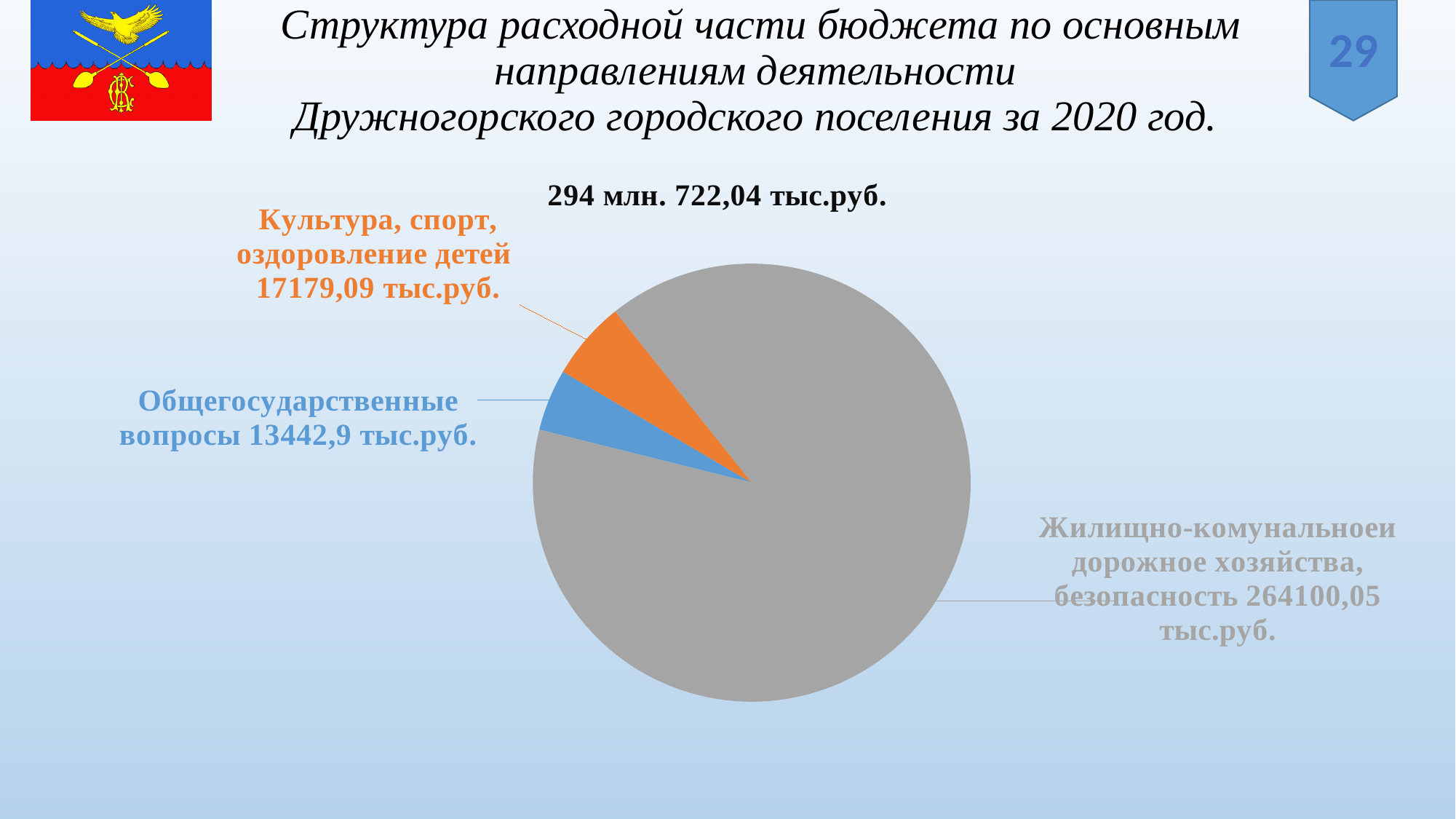
What is the value for Культура, спорт, оздоровление детей? 17179,09 тыс.руб. Which is larger: Культура, спорт, оздоровление детей or Общегосударственные вопросы? Культура, спорт, оздоровление детей What kind of chart is shown on the slide? Pie chart How many slices does the pie chart have? 3 What is the value for Общегосударственные вопросы? 13442,9 тыс.руб. What colour is the slice for Общегосударственные вопросы? Blue Which category has the smallest slice of the pie? Общегосударственные вопросы What is the difference between Жилищно-коммунальное и дорожное хозяйства, безопасность and Культура, спорт, оздоровление детей? 246920,96 тыс.руб. Which category has the largest slice of the pie? Жилищно-коммунальное и дорожное хозяйства, безопасность What is the difference between Культура, спорт, оздоровление детей and Общегосударственные вопросы? 3736,19 тыс.руб. What is the value for Жилищно-коммунальное и дорожное хозяйства, безопасность? 264100,05 тыс.руб. What total amount is shown as the title of the pie chart? 294 млн. 722,04 тыс.руб.